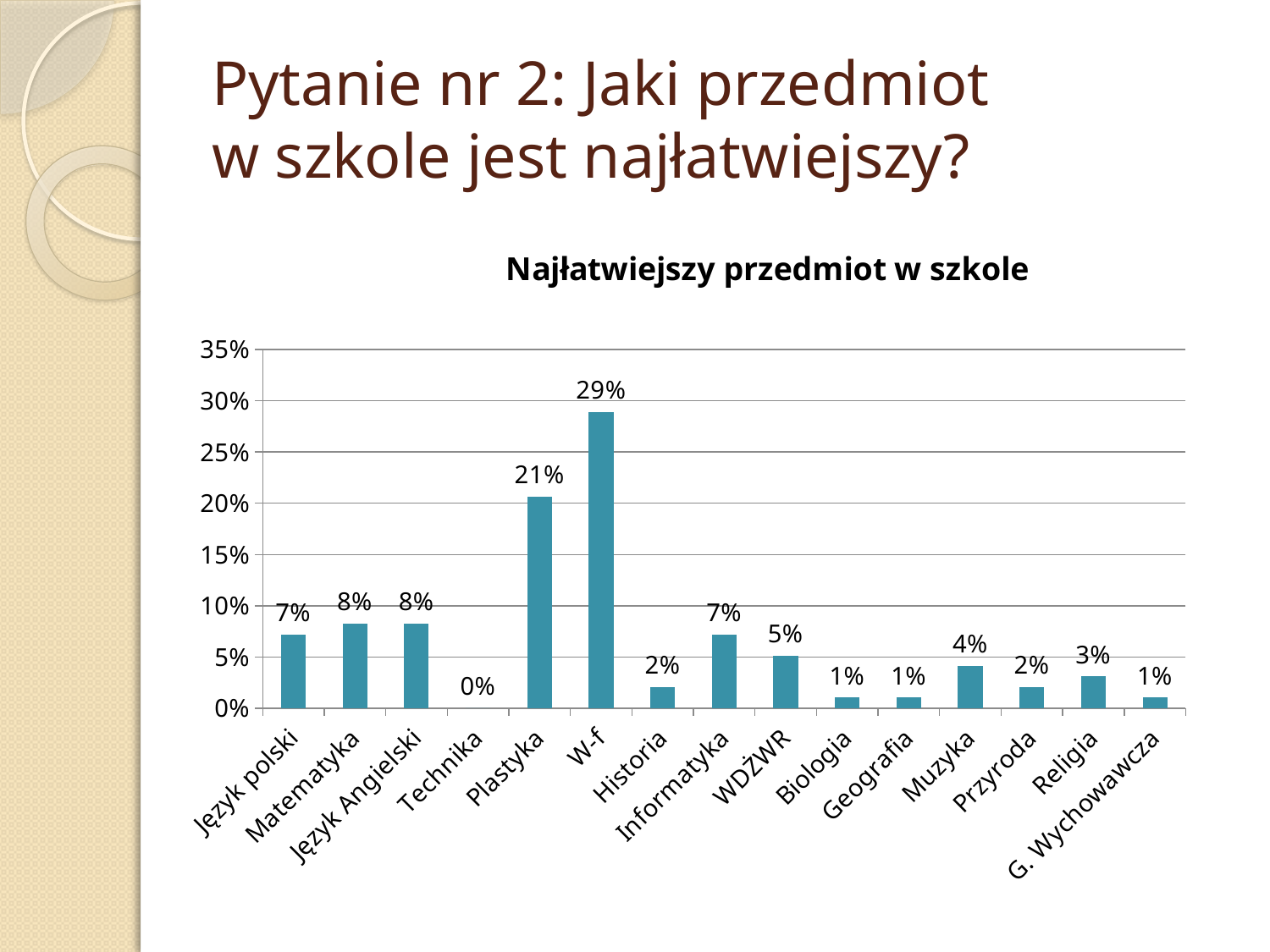
What kind of chart is shown on the slide? bar chart What is the title of the chart? Najłatwiejszy przedmiot w szkole What is the value for Technika? 0% Which is larger, the value for Muzyka or the value for Religia? Muzyka What is the difference between the values for W-f and Plastyka? 8% What is the value for W-f? 29% Which subject has the lowest value? Technika Is the value for Plastyka greater or less than 20%? greater What is the value for Plastyka? 21% How many subjects are shown on the x axis? 15 What is the value for Informatyka? 7% Which subject has the highest value? W-f